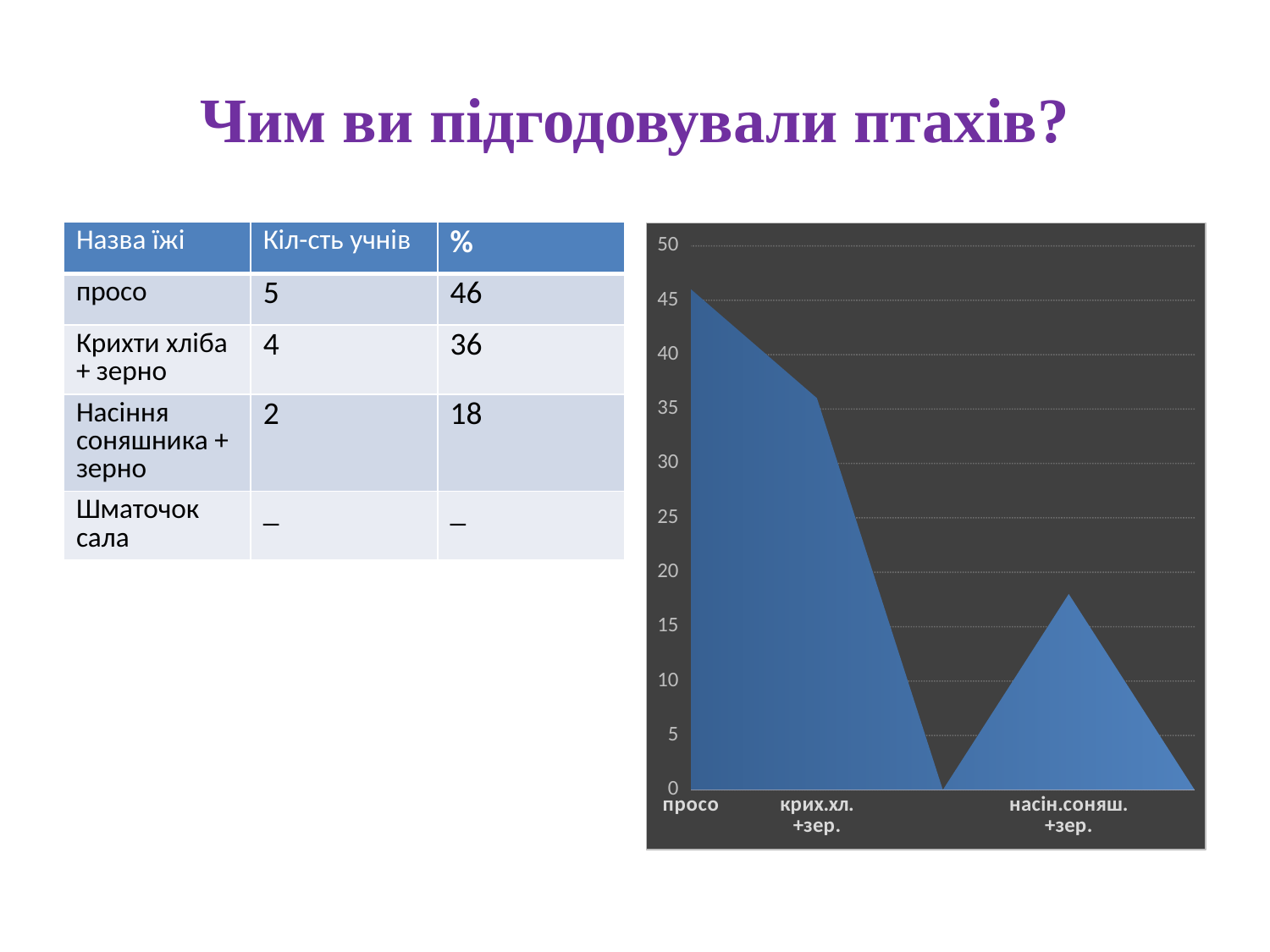
Which is larger, the value for просо or the value for крих.хл.+зер.? просо Is the value for просо greater or less than 40? greater Does the value fall or rise from просо to крих.хл.+зер.? fall What colour is the filled area in the chart? blue Is the value for насін.соняш.+зер. greater or less than 10? greater Which is larger, the value for крих.хл.+зер. or the value for насін.соняш.+зер.? крих.хл.+зер. What kind of chart is shown on the slide? area chart Is the value for крих.хл.+зер. greater or less than 30? greater What is the highest value shown on the vertical axis of the chart? 50 Which category has the highest value in the chart? просо